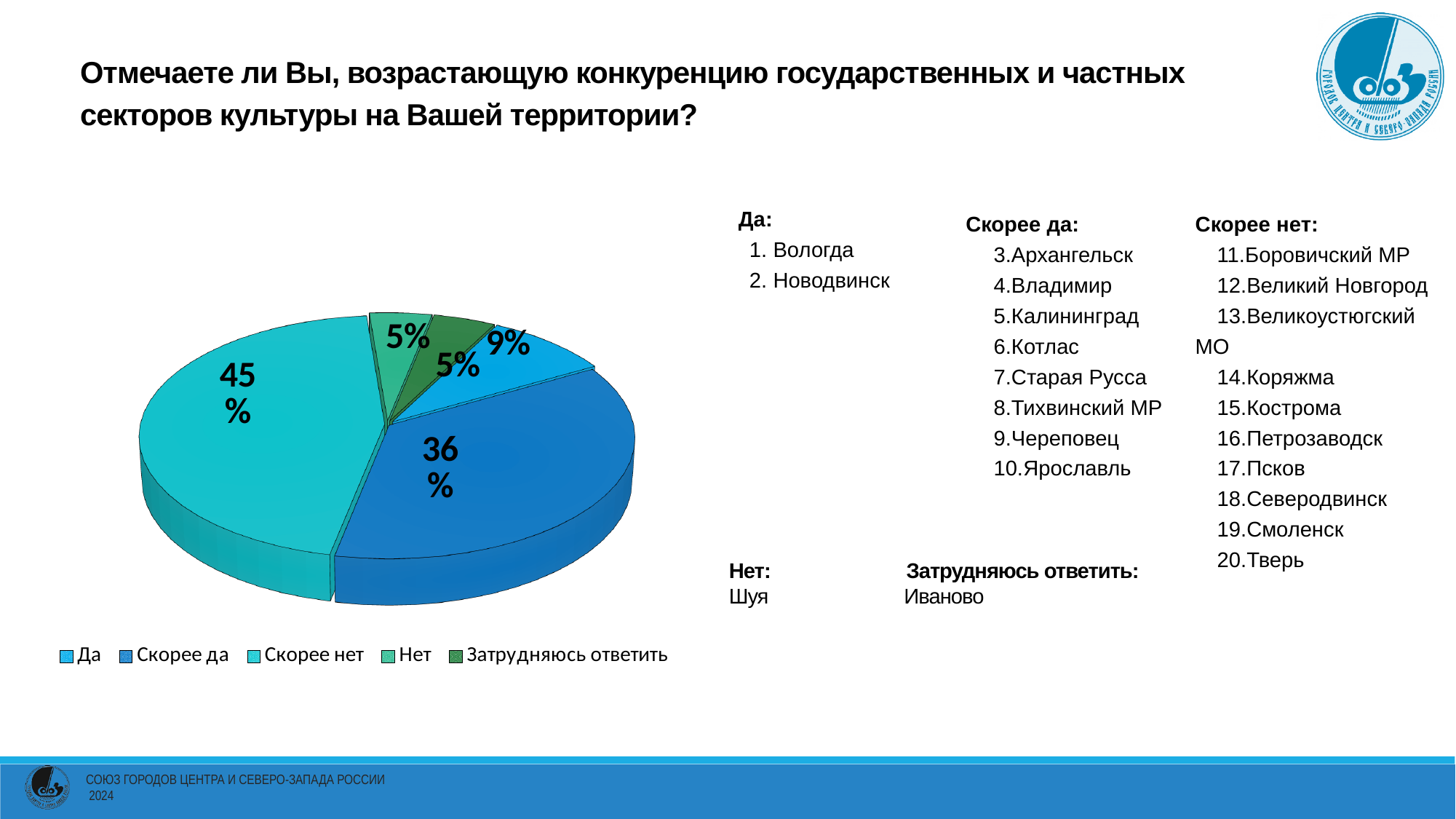
What kind of chart is shown on the slide? pie chart How many slices does the pie chart have? 5 How many entries does the legend list? 5 Which legend entry is listed first in the chart legend? Да What percentage of the pie is labelled for "Скорее нет"? 45% What percentage of the pie is labelled for "Скорее да"? 36% What is the difference between the "Скорее нет" and "Скорее да" slices? 9% Which slice is larger, "Да" or "Нет"? Да What is the combined share of the "Да" and "Скорее да" slices? 45% Which answer category has the largest slice of the pie? Скорее нет What percentage of the pie is labelled for "Да"? 9% What percentage of the pie is labelled for "Нет"? 5%